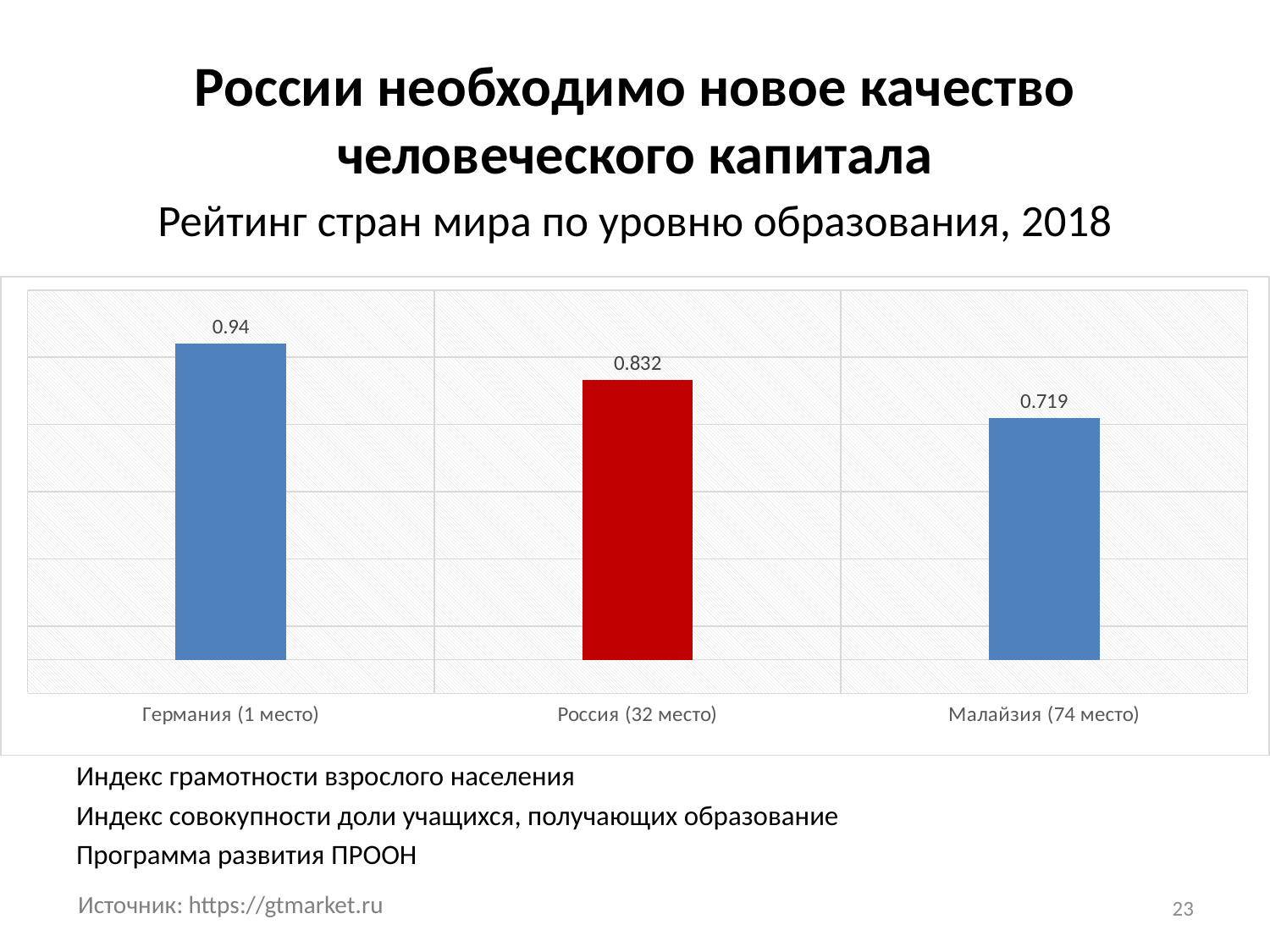
What kind of chart is shown on the slide? bar chart What is the value for Малайзия (74 место)? 0.719 Which country has the highest value? Германия (1 место) How many countries are shown in the chart? 3 Do the values rise or fall from left to right across the chart? fall Which country has the lowest value? Малайзия (74 место) Which bar is coloured red? Россия (32 место) What is the difference between the values for Германия and Россия? 0.108 What is the value for Германия (1 место)? 0.94 What is the value for Россия (32 место)? 0.832 What is the difference between the values for Россия and Малайзия? 0.113 Which is larger, the value for Россия or the value for Малайзия? Россия